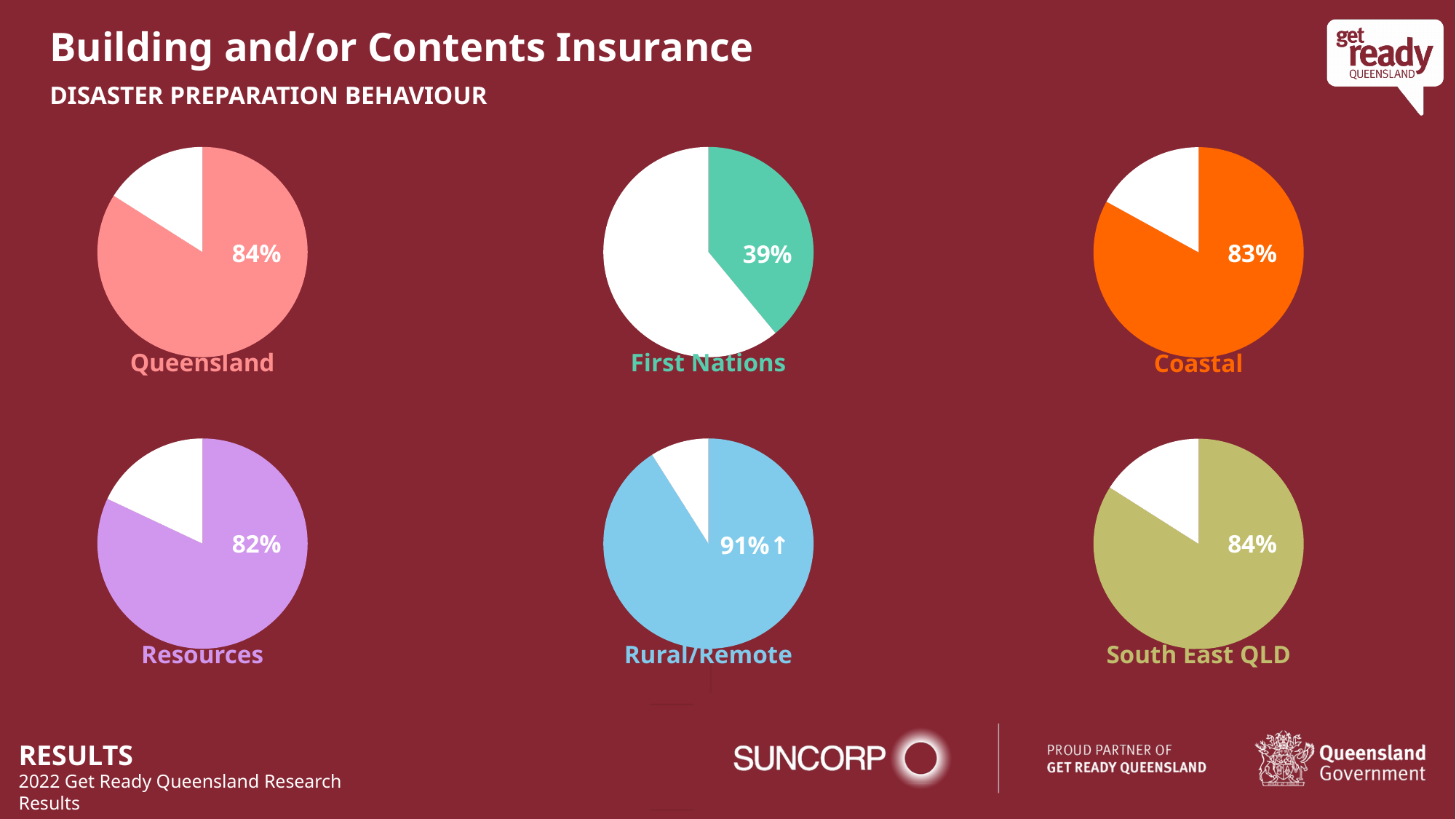
In the Queensland pie chart, what percentage is shown for the coloured slice? 84% What type of chart is used to show each group's percentage on the slide? Pie chart In the South East QLD pie chart, what percentage is shown for the coloured slice? 84% What is the difference between the Rural/Remote percentage and the First Nations percentage? 52% How many pie charts are shown on the slide? 6 In the Coastal pie chart, what percentage is shown for the coloured slice? 83% Which is larger, the Coastal percentage or the Resources percentage? Coastal Across all the pie charts on the slide, which group has the lowest percentage? First Nations In the First Nations pie chart, what percentage is shown for the coloured slice? 39% In the Resources pie chart, what percentage is shown for the coloured slice? 82% In the Rural/Remote pie chart, what percentage is shown for the coloured slice? 91% Across all the pie charts on the slide, which group has the highest percentage? Rural/Remote